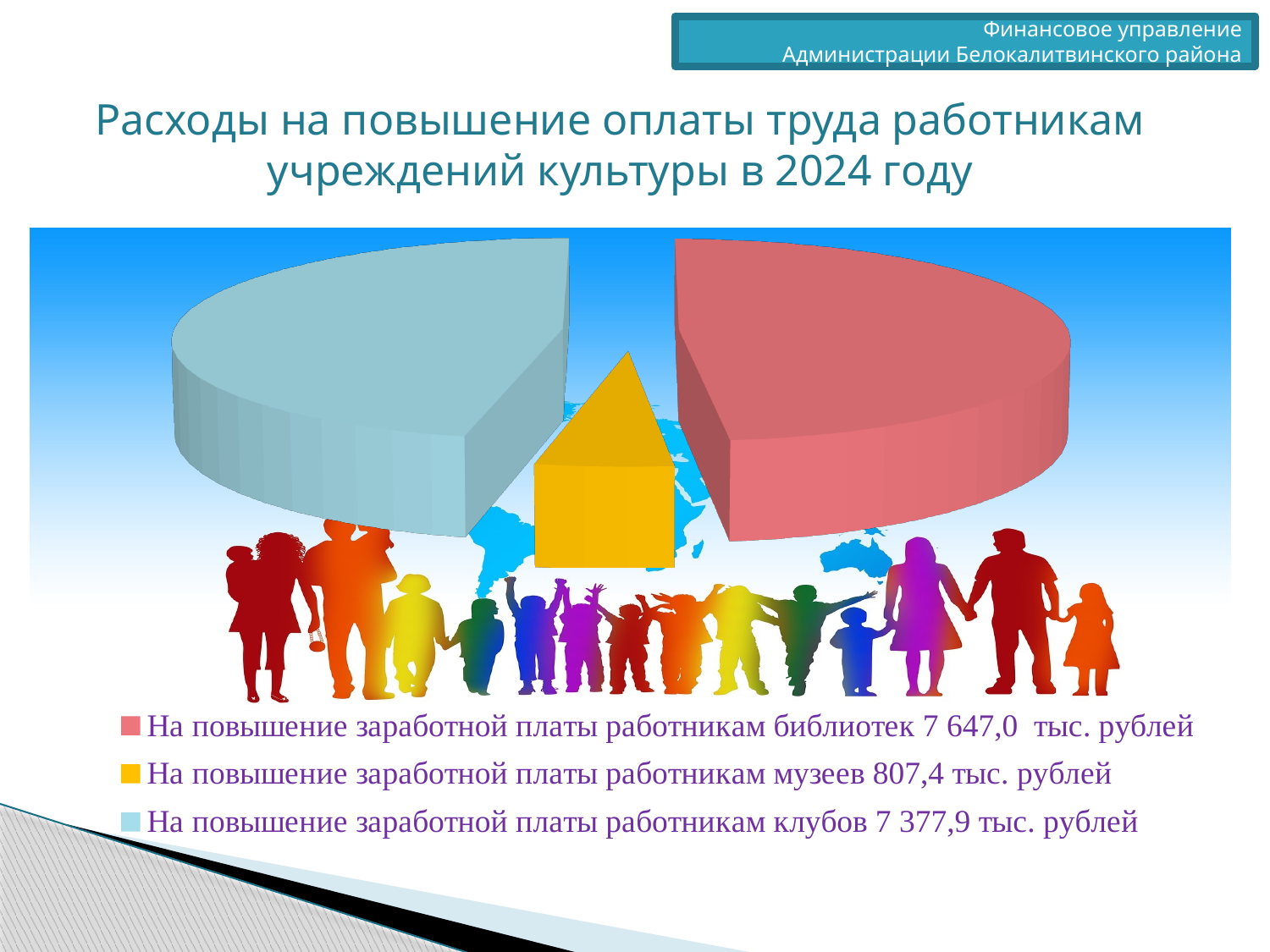
What is the difference between the value for библиотек and the value for клубов? 269,1 тыс. рублей What is the value for «На повышение заработной платы работникам библиотек»? 7 647,0 тыс. рублей Which is larger: the value for работникам клубов or the value for работникам музеев? работникам клубов Which category has the smallest value? На повышение заработной платы работникам музеев What is the value for «На повышение заработной платы работникам музеев»? 807,4 тыс. рублей Which category has the largest value? На повышение заработной платы работникам библиотек What is the difference between the value for клубов and the value for музеев? 6 570,5 тыс. рублей What is the total of all three categories? 15 832,3 тыс. рублей Which colour represents «На повышение заработной платы работникам музеев»? Yellow What is the value for «На повышение заработной платы работникам клубов»? 7 377,9 тыс. рублей How many categories does the pie chart have? 3 What type of chart is shown on the slide? Pie chart